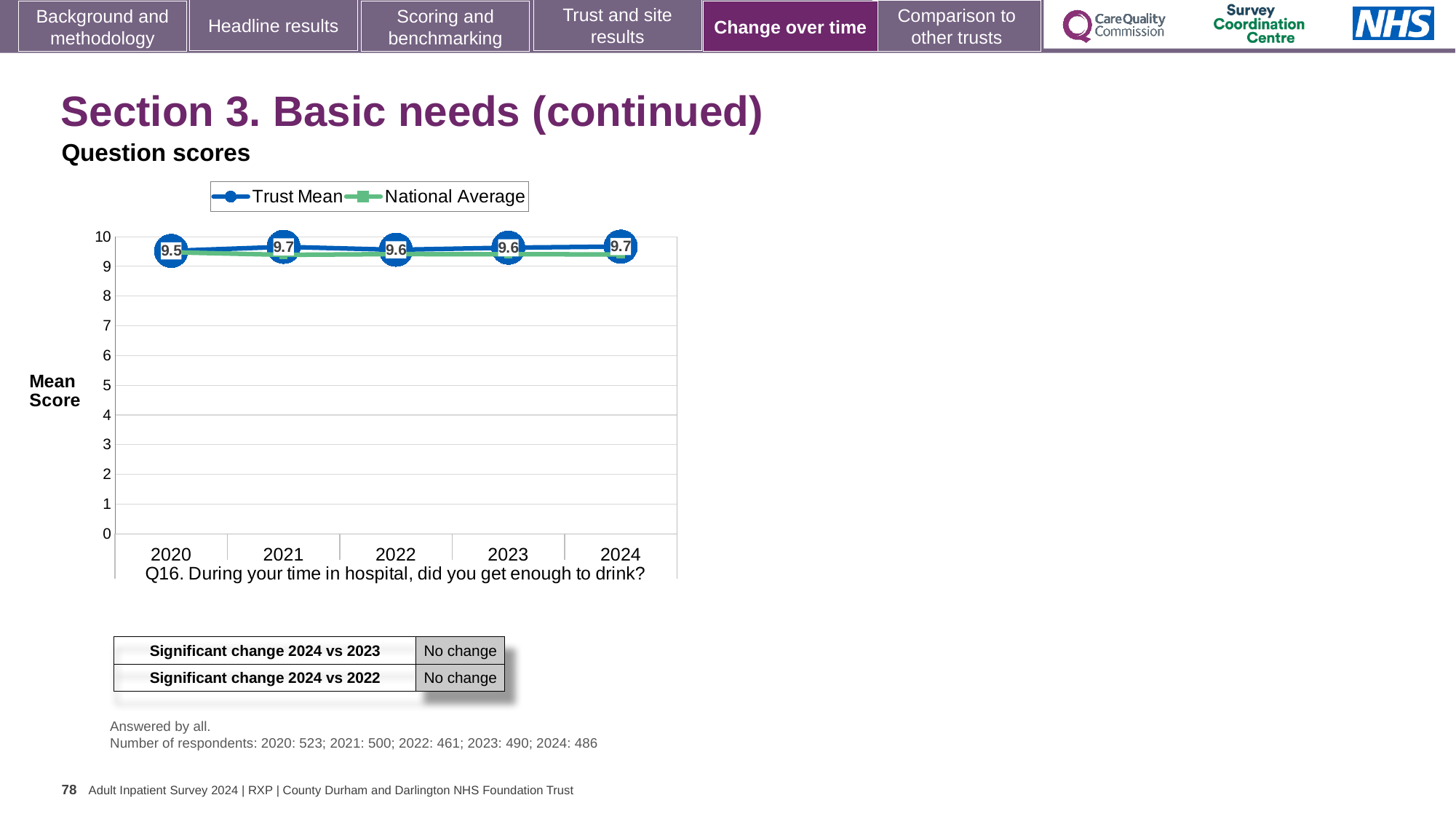
What kind of chart is shown on the slide? line chart Which year has the higher Trust Mean score, 2020 or 2021? 2021 How many series does the legend list? 2 Is the National Average value for 2024 greater or less than 9? greater How many years are plotted on the x axis? 5 What is the Trust Mean score for 2024? 9.7 In which year is the Trust Mean score lowest? 2020 What is the difference between the Trust Mean score in 2024 and in 2020? 0.2 What is the Trust Mean score for 2022? 9.6 Which survey question does the chart show scores for? Q16. During your time in hospital, did you get enough to drink? What is the Trust Mean score for 2021? 9.7 What is the Trust Mean score for 2020? 9.5